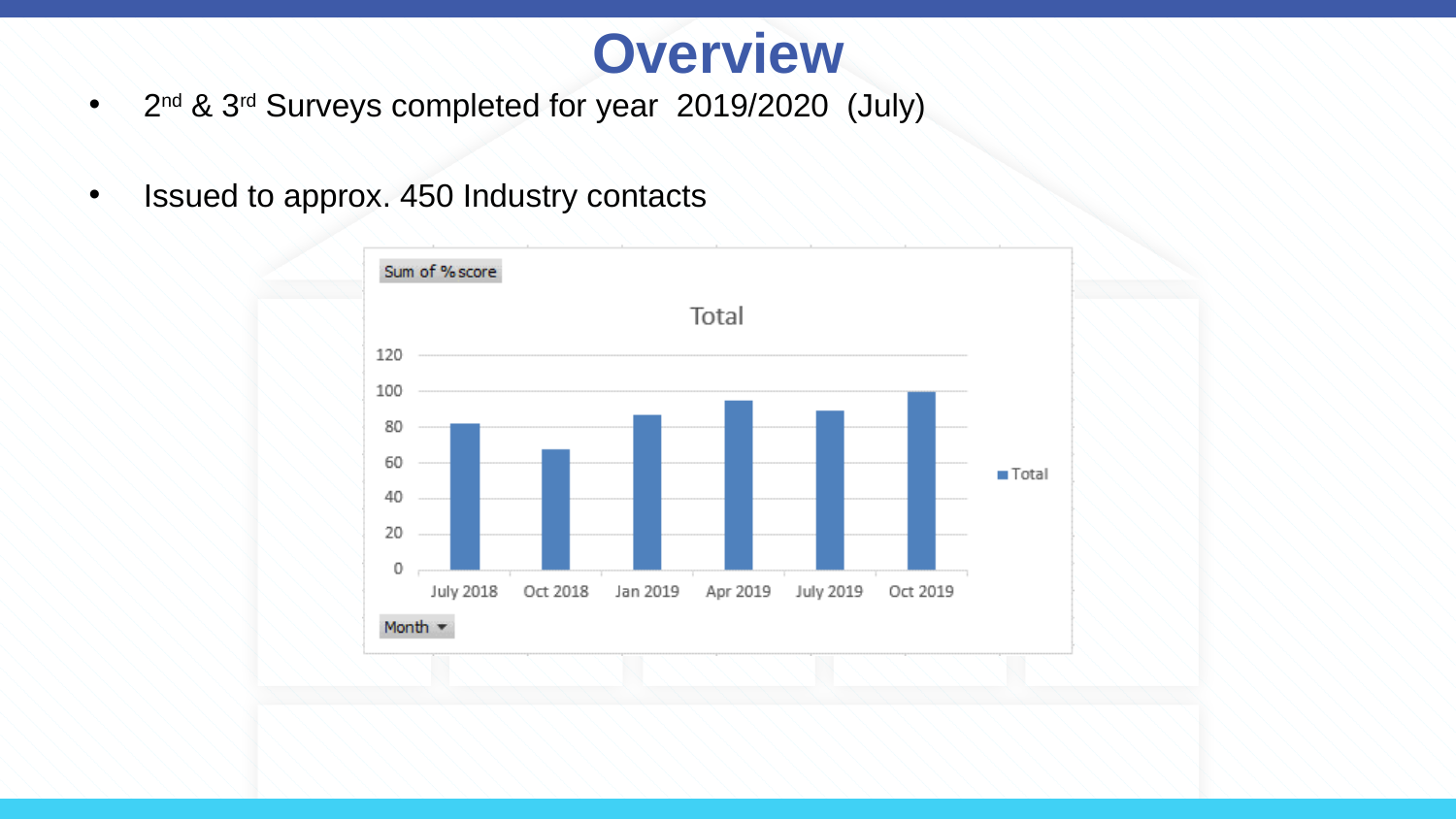
How many series does the chart's legend list? 1 Which month has the highest value in the chart? Oct 2019 How many months are shown on the x axis of the chart? 6 Is the value for Jan 2019 greater or less than 60? greater Which month has the lowest value in the chart? Oct 2018 Is the value for Apr 2019 greater or less than 80? greater Is the value for July 2018 greater or less than 100? less Which is larger, the value for July 2018 or the value for Oct 2018? July 2018 What kind of chart is shown on the slide? bar chart What is the title of the chart? Total What entry is shown in the chart's legend? Total